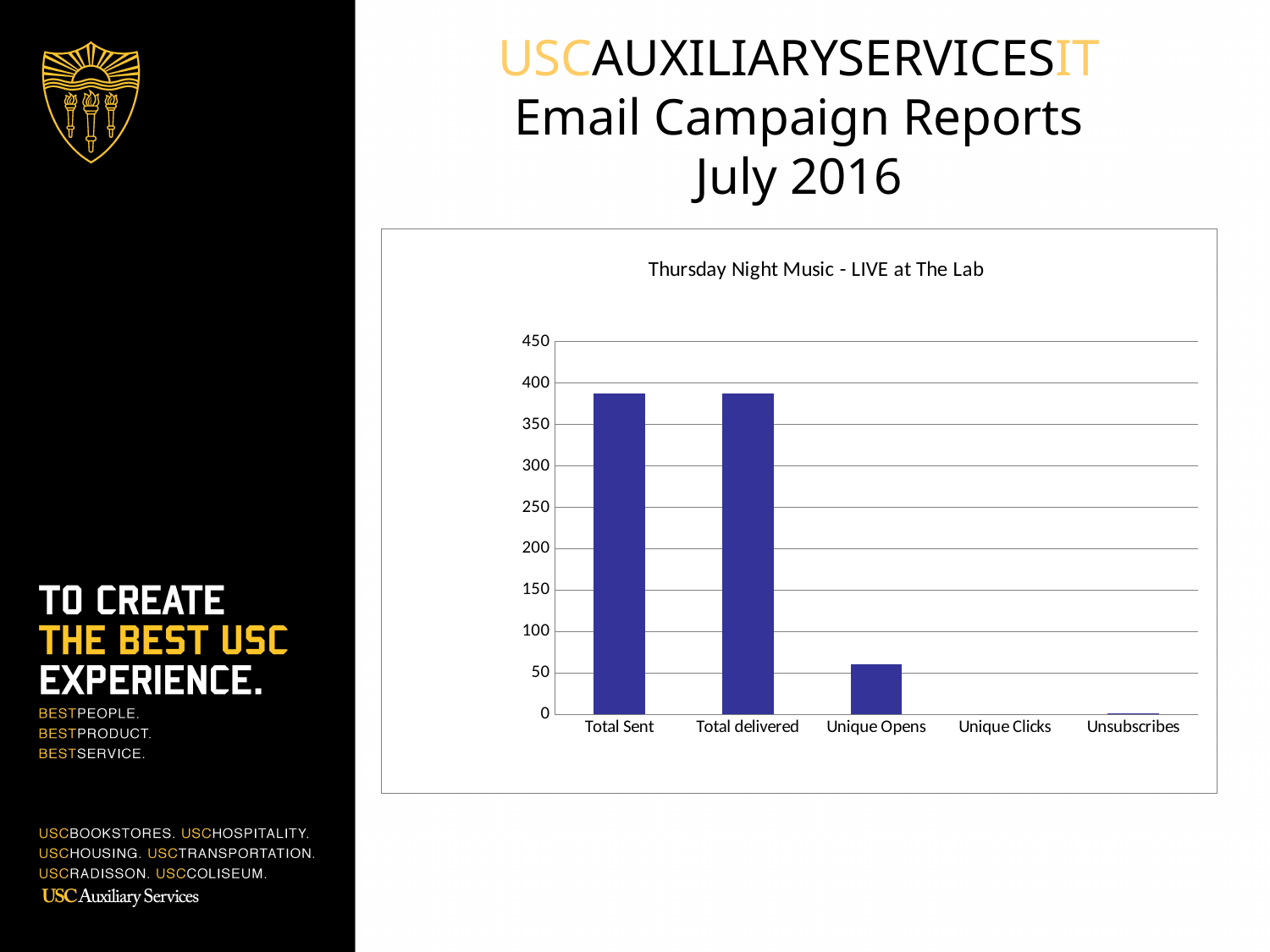
Is the value for Unique Opens greater or less than 50? greater What is the highest value shown on the vertical axis of the chart? 450 Is the value for Unique Clicks greater or less than 50? less Is the value for Total delivered greater or less than 400? less How many categories are shown on the x axis of the chart? 5 Which is larger, the value for Unique Opens or the value for Unsubscribes? Unique Opens Which is larger, the value for Total Sent or the value for Unique Opens? Total Sent What kind of chart is shown on the slide? bar chart Do the values generally rise or fall moving from left to right along the x axis? fall What is the title of the chart? Thursday Night Music - LIVE at The Lab